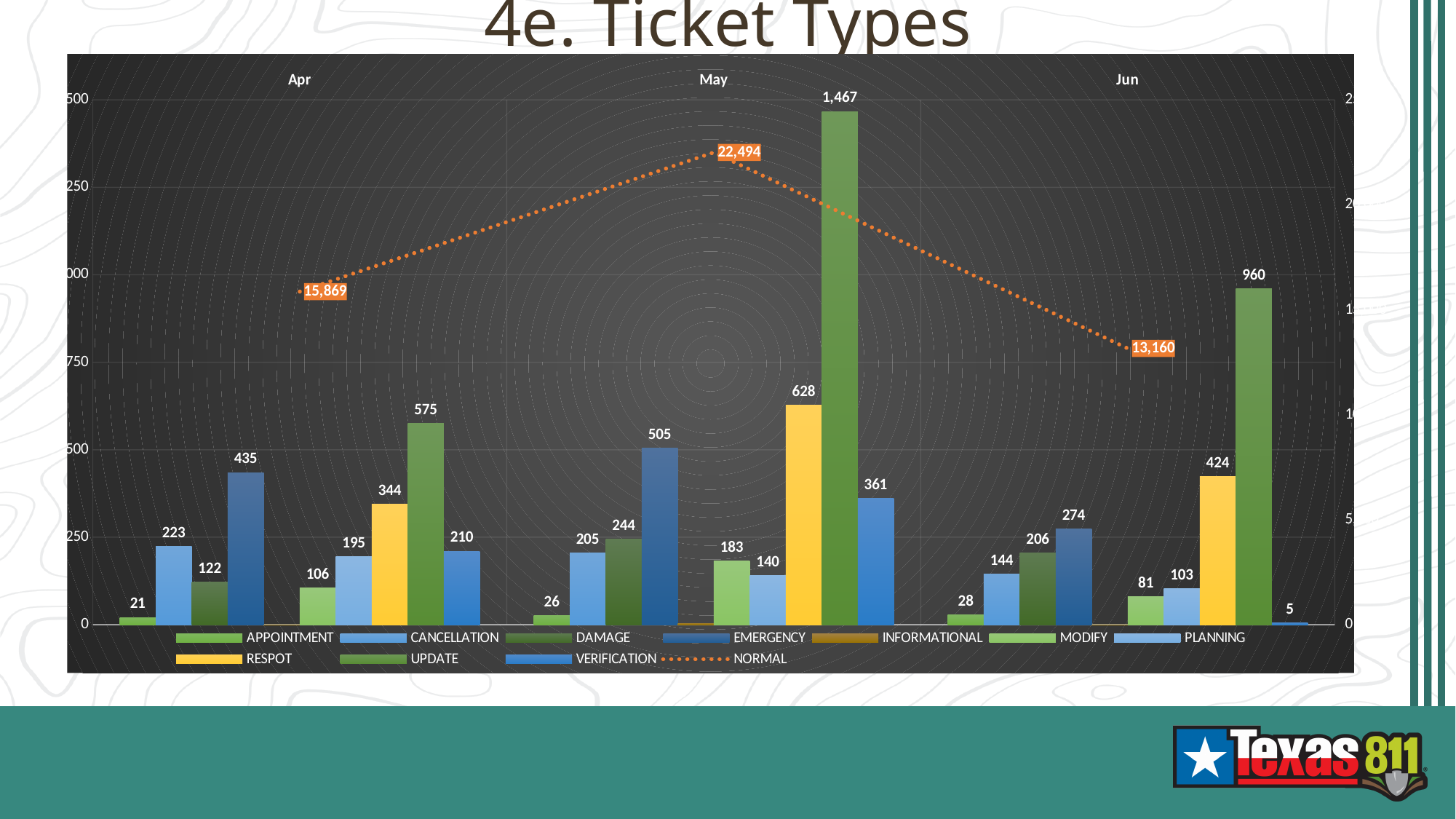
What is the NORMAL value shown for Jun? 13,160 Which is larger, the EMERGENCY value for Apr or for May? May What is the difference between the UPDATE values for May and Jun? 507 How many months are shown on the x axis? 3 In which month is the UPDATE bar the lowest? Apr In which month is the NORMAL line at its highest? May What is the value of the UPDATE bar for May? 1,467 What kind of chart is this? Bar chart with a line How does the NORMAL line change from Apr to Jun? Rises from Apr to May, then falls to Jun How many series does the legend list? 11 What is the difference between the RESPOT values for May and Apr? 284 What is the value of the RESPOT bar for Apr? 344